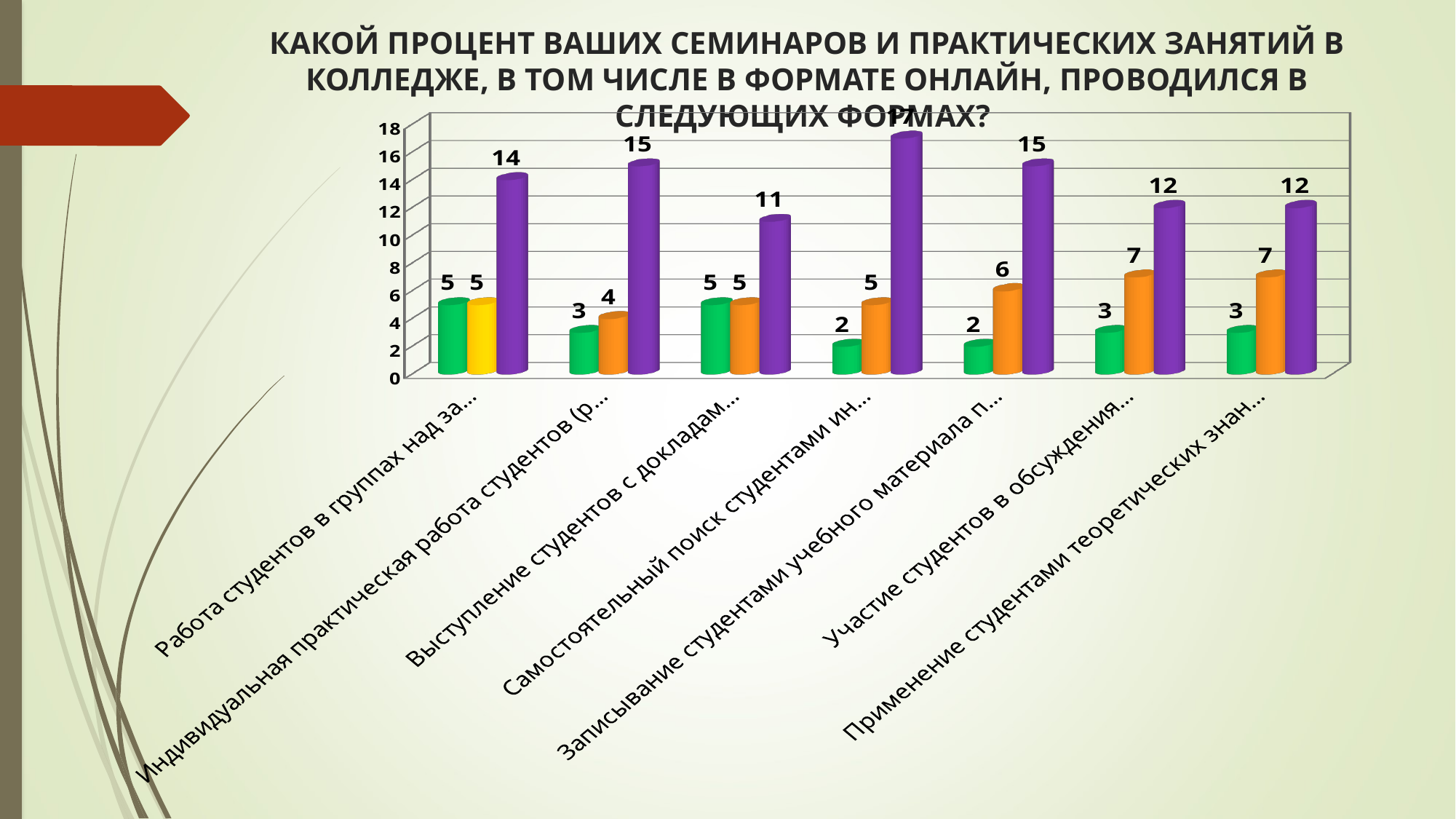
What is the difference between the purple bar and the orange bar for the category "Участие студентов в обсуждения..."? 5 What is the value of the purple bar for the category "Индивидуальная практическая работа студентов"? 15 What type of chart is shown on the slide? bar chart How many categories are shown on the x axis of the chart? 7 What is the value of the purple bar for the category "Работа студентов в группах над за..."? 14 What is the highest value shown on the vertical axis of the chart? 18 What is the value of the purple bar for the category "Выступление студентов с докладам..."? 11 Is the value of the purple bar for "Самостоятельный поиск студентами ин..." greater or less than 14? greater Which is larger: the orange bar for "Применение студентами теоретических знан..." or the orange bar for "Индивидуальная практическая работа студентов"? Применение студентами теоретических знан... Among the purple bars with printed labels, which category has the lowest value? Выступление студентов с докладам... What is the value of the orange bar for the category "Записывание студентами учебного материала"? 6 What is the value of the green bar for the category "Самостоятельный поиск студентами ин..."? 2